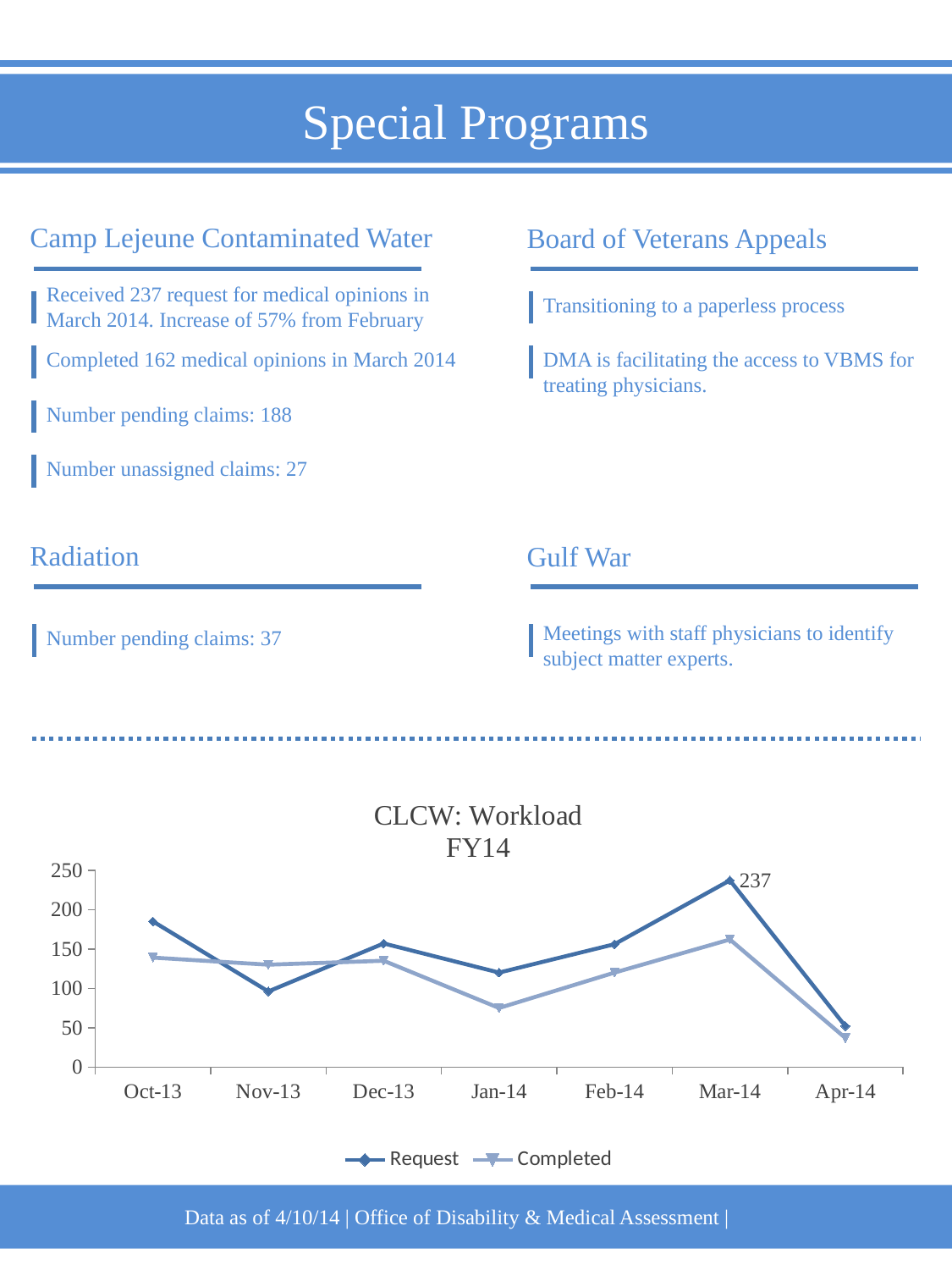
In the CLCW: Workload FY14 chart, which month has the highest Completed value? Mar-14 In the CLCW: Workload FY14 chart, does the Request line rise or fall from Mar-14 to Apr-14? Fall In the CLCW: Workload FY14 chart, is the Completed value for Jan-14 greater or less than 100? less What are the two series named in the legend of the CLCW: Workload FY14 chart? Request and Completed How many series does the legend of the CLCW: Workload FY14 chart list? 2 In the CLCW: Workload FY14 chart, which month has the highest Request value? Mar-14 How many months are plotted along the x axis of the CLCW: Workload FY14 chart? 7 In the CLCW: Workload FY14 chart, which month has the lowest Request value? Apr-14 In the CLCW: Workload FY14 chart, what is the Request value for Mar-14? 237 What kind of chart is the CLCW: Workload FY14 chart? Line chart In the CLCW: Workload FY14 chart, which series has the larger value in Nov-13, Request or Completed? Completed In the CLCW: Workload FY14 chart, is the Request value for Oct-13 greater or less than 150? greater